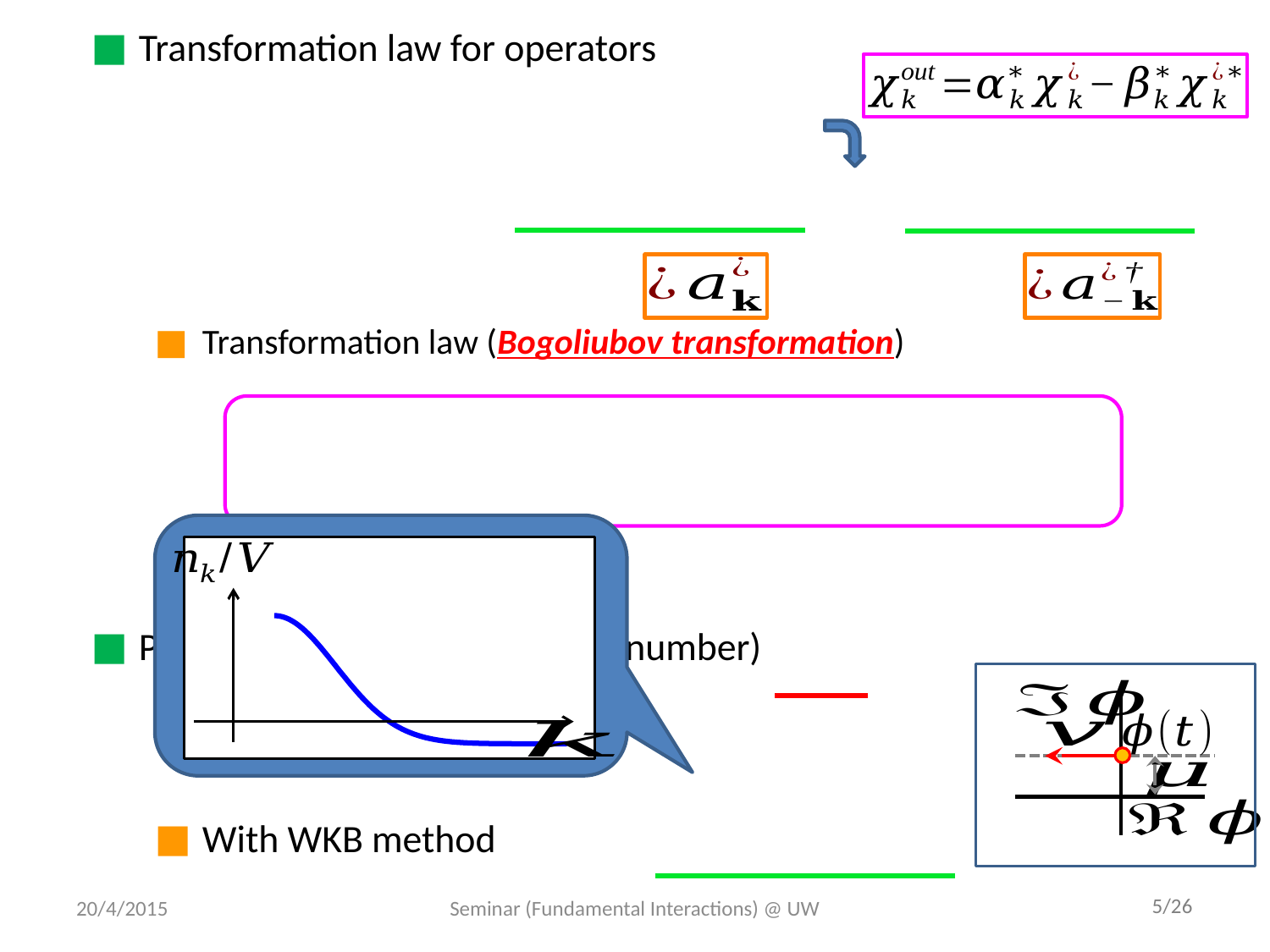
What kind of chart is shown in the callout box at the lower left of the slide? line chart In the chart in the callout box, what is the label on the horizontal axis? k How many curves are plotted in the chart in the callout box? 1 In the chart in the callout box, does the plotted curve rise or fall as k increases? fall In the chart in the callout box, what is the label on the vertical axis? n_k/V